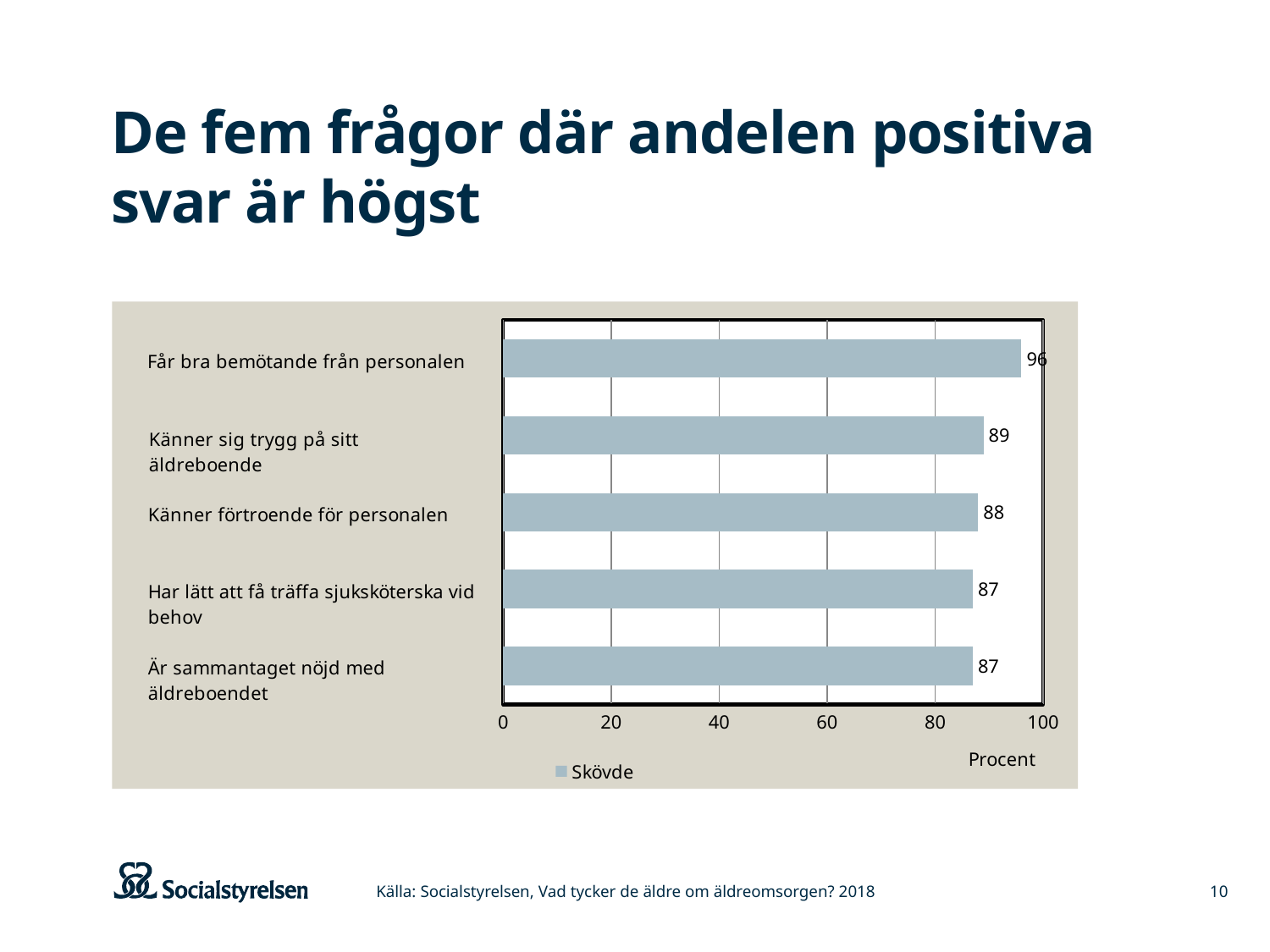
Which category has the highest value? Får bra bemötande från personalen How many categories are shown in the chart? 5 What is the value for "Känner sig trygg på sitt äldreboende"? 89 What is the value for "Får bra bemötande från personalen"? 96 Which is larger, the value for "Får bra bemötande från personalen" or the value for "Känner förtroende för personalen"? Får bra bemötande från personalen What is the value for "Är sammantaget nöjd med äldreboendet"? 87 What series name is shown in the legend? Skövde How many series does the legend list? 1 What kind of chart is shown on the slide? Bar chart What is the value for "Känner förtroende för personalen"? 88 What is the difference between the values for "Får bra bemötande från personalen" and "Känner sig trygg på sitt äldreboende"? 7 What is the difference between the values for "Känner förtroende för personalen" and "Har lätt att få träffa sjuksköterska vid behov"? 1